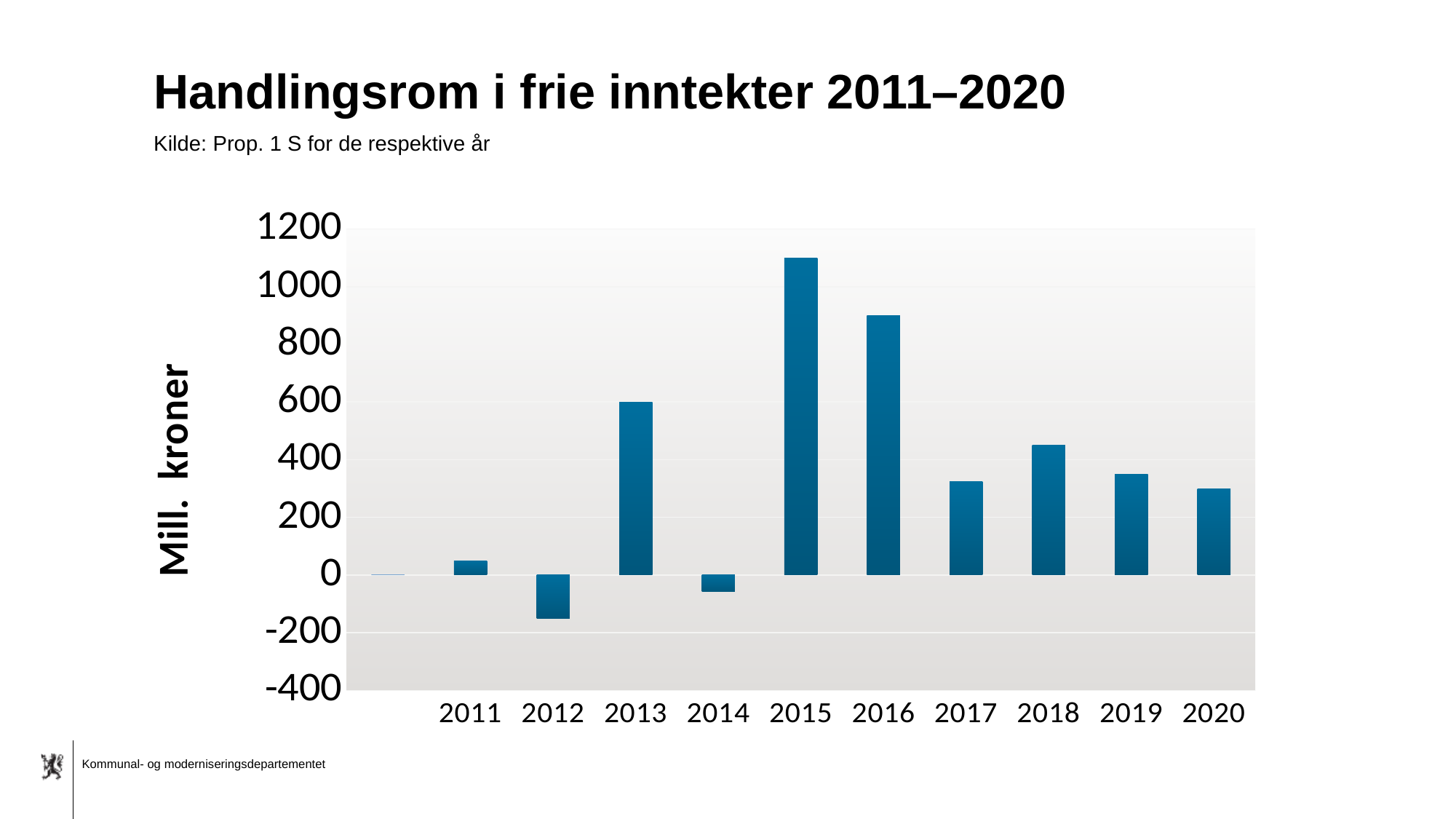
Is the value for 2013 greater or less than 400? greater What kind of chart is shown on the slide? bar chart Do the values rise or fall from 2015 to 2017? fall What is the label on the vertical axis of the chart? Mill. kroner Which year has the larger value, 2016 or 2018? 2016 Is the value for 2015 greater or less than 1000? greater What is the title of the chart on the slide? Handlingsrom i frie inntekter 2011–2020 Which year has the lowest value in the chart? 2012 Which year has the highest value in the chart? 2015 Is the value for 2012 greater or less than 0? less How many labelled years are shown on the x axis? 10